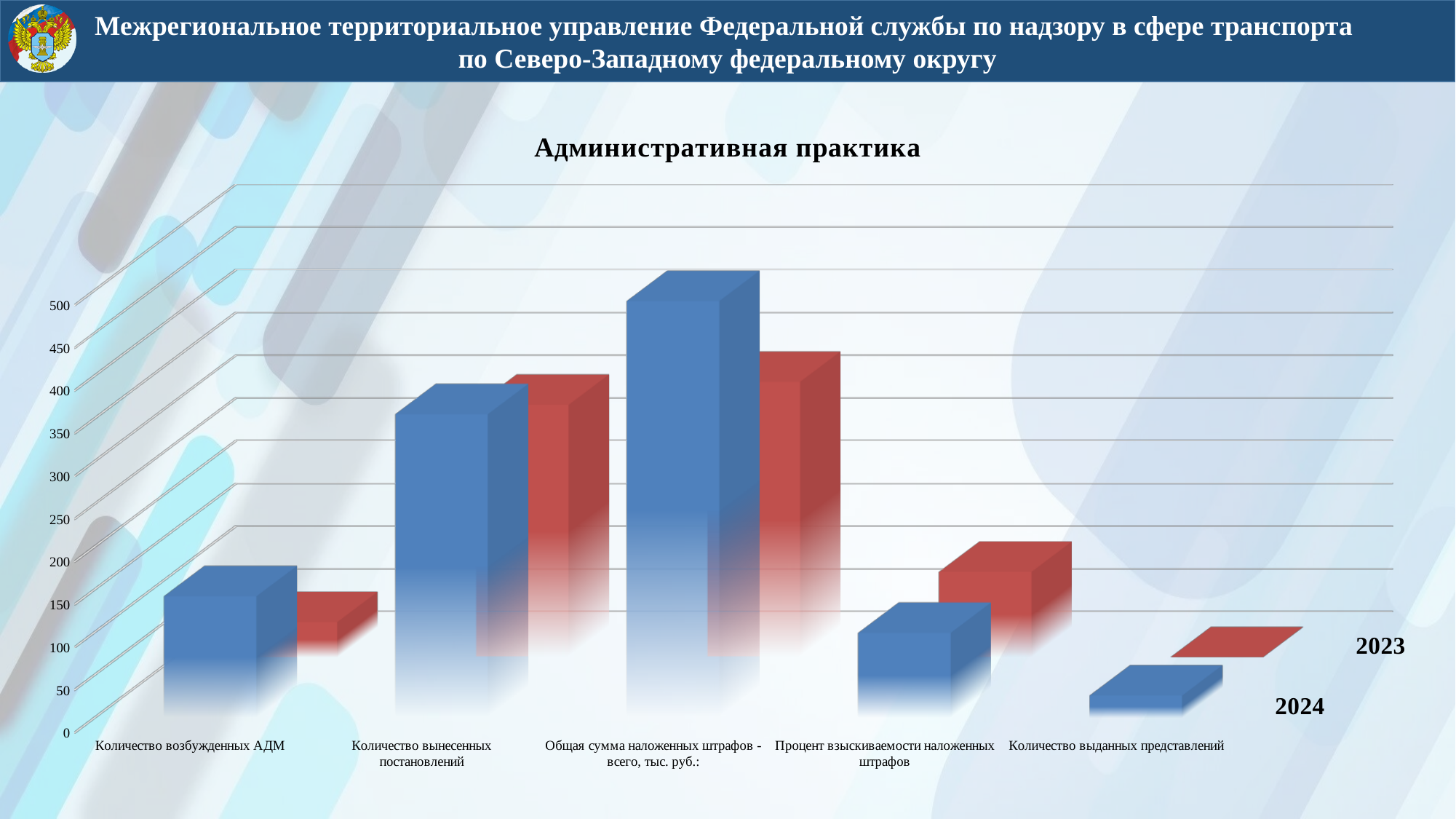
Which category has the lowest value for the 2024 series? Количество выданных представлений Is the 2024 value for "Количество возбужденных АДМ" greater or less than 250? less Which category has the highest value for the 2024 series? Общая сумма наложенных штрафов - всего, тыс. руб. Which category has the highest value for the 2023 series? Общая сумма наложенных штрафов - всего, тыс. руб. Is the 2024 value for "Общая сумма наложенных штрафов - всего, тыс. руб." greater or less than 450? greater Is the 2024 value for "Количество вынесенных постановлений" greater or less than 300? greater Which colour represents the 2024 series in the chart? blue How many series does the chart show? 2 How many categories are shown on the x axis of the chart? 5 Which category has the lowest value for the 2023 series? Количество выданных представлений What is the title of the chart? Административная практика What kind of chart is shown on the slide? bar chart